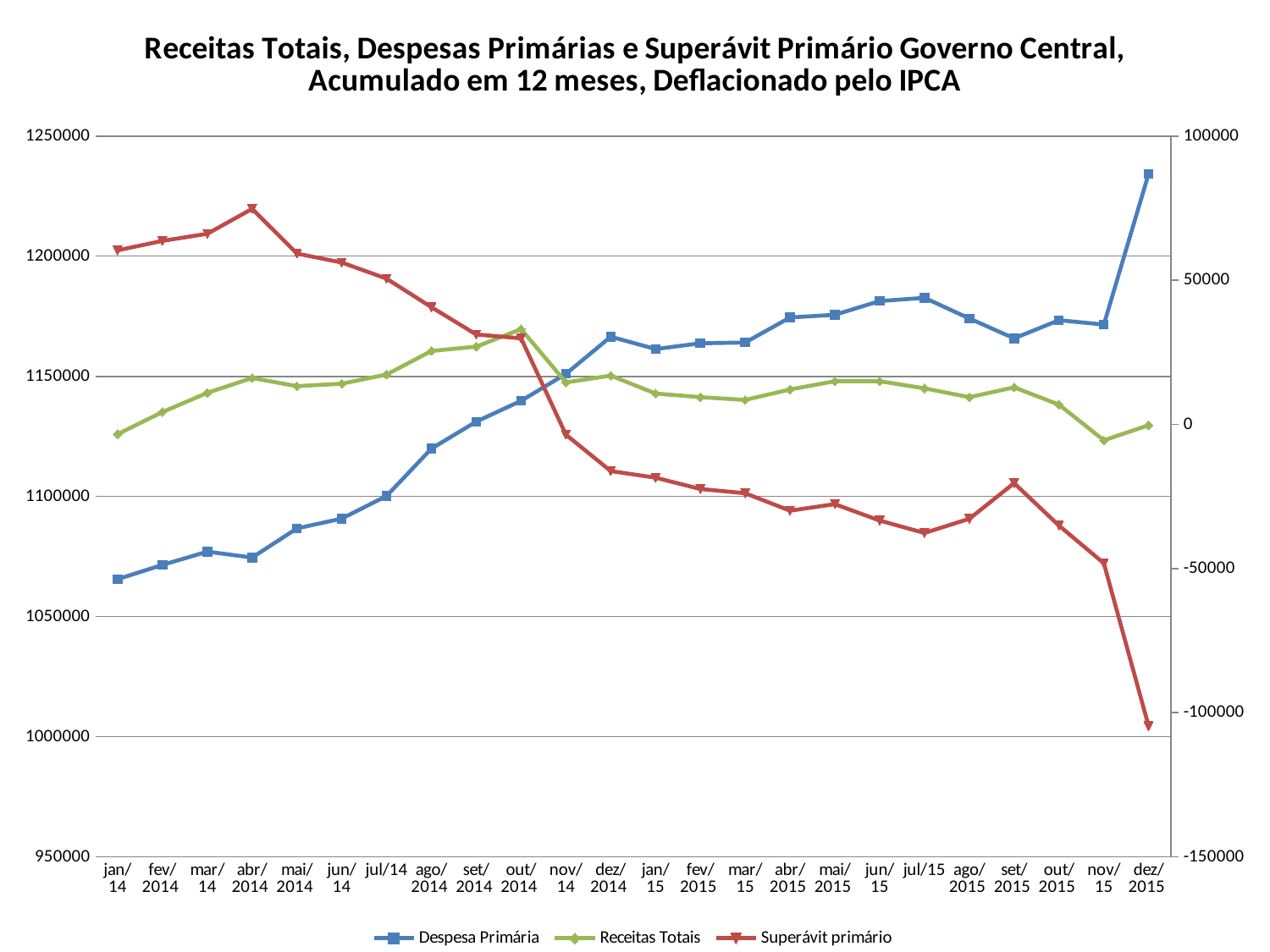
In jan/14, which is higher: Receitas Totais or Despesa Primária? Receitas Totais Is the value for Despesa Primária in dez/2015 greater or less than 1200000? greater In which month is the Superávit primário series at its lowest? dez/2015 How many monthly points are plotted along the x axis? 24 Is the value for Superávit primário in dez/2015 greater or less than -100000 on the right axis? less In which month is the Despesa Primária series at its lowest? jan/14 In which month does the Superávit primário series reach its highest value? abr/2014 Does the Superávit primário series overall rise or fall from jan/14 to dez/2015? fall What colour is the line for Receitas Totais? green In which month does the Despesa Primária series reach its highest value? dez/2015 What kind of chart is shown on the slide? line chart How many series does the legend list? 3